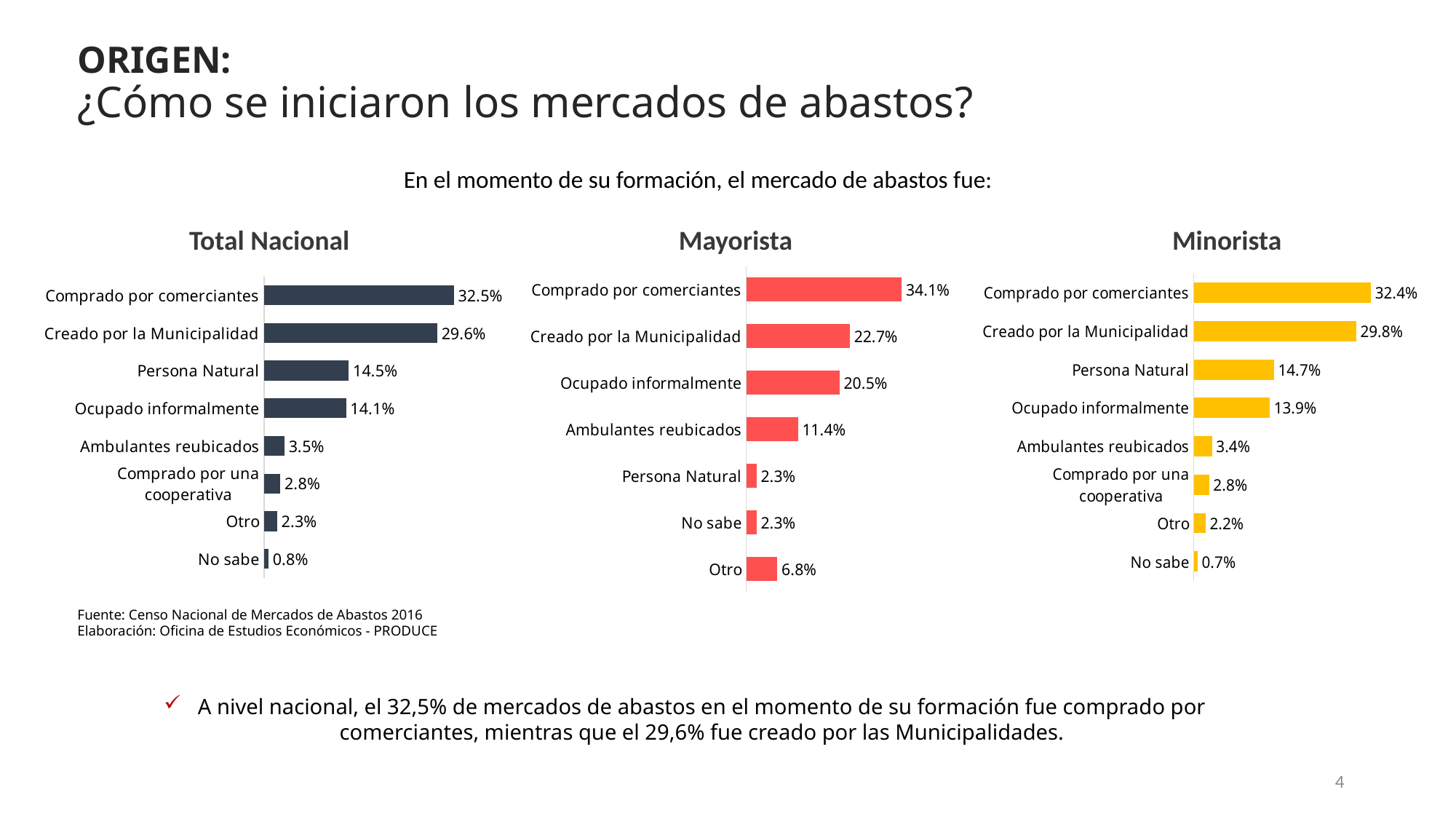
In the Total Nacional chart, what is the value for Creado por la Municipalidad? 29.6% How many categories does the Total Nacional chart show? 8 In the Total Nacional chart, what is the difference between Comprado por comerciantes and Creado por la Municipalidad? 2.9% In the Mayorista chart, what is the value for Ocupado informalmente? 20.5% What kind of chart is the Minorista chart? Bar chart In the Mayorista chart, which is larger: Ambulantes reubicados or Otro? Ambulantes reubicados In the Mayorista chart, what is the difference between Creado por la Municipalidad and Ocupado informalmente? 2.2% What colour are the bars in the Minorista chart? Yellow In the Minorista chart, what is the value for Persona Natural? 14.7% In the Minorista chart, which category has the lowest value? No sabe In the Mayorista chart, which category has the highest value? Comprado por comerciantes How many categories does the Mayorista chart show? 7